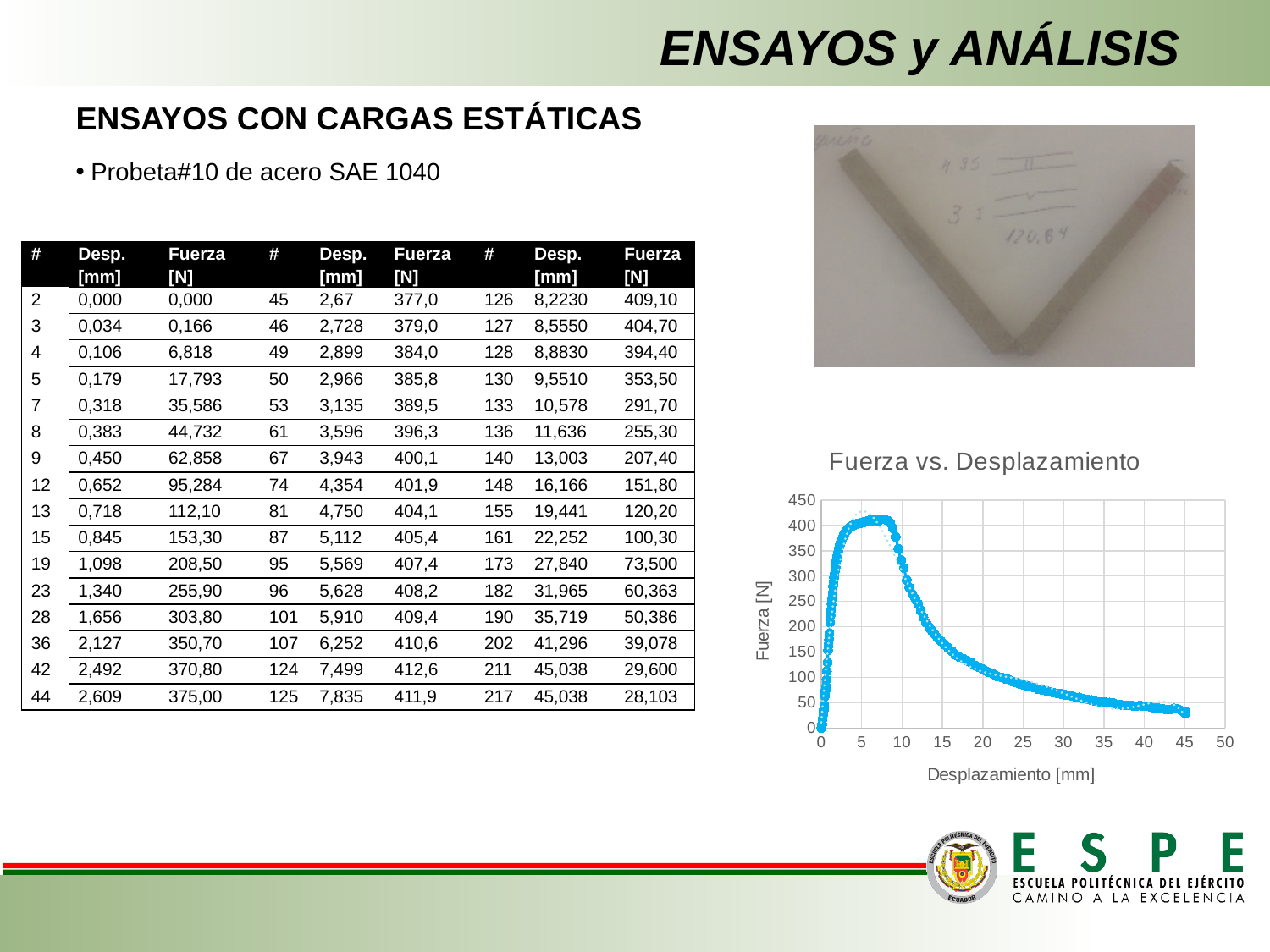
Which has the larger force value: the point at 10 mm displacement or the point at 25 mm displacement? 10 mm Is the peak force value in the chart greater or less than 350? greater After the peak, do the force values rise or fall as displacement increases? fall What kind of chart is shown on the slide? scatter chart Is the force value at a displacement of 5 mm greater or less than 350? greater What is the highest value shown on the y axis of the chart? 450 Is the force value at a displacement of 20 mm greater or less than 150? less What is the label of the x axis of the chart? Desplazamiento [mm] What is the title of the chart on the slide? Fuerza vs. Desplazamiento